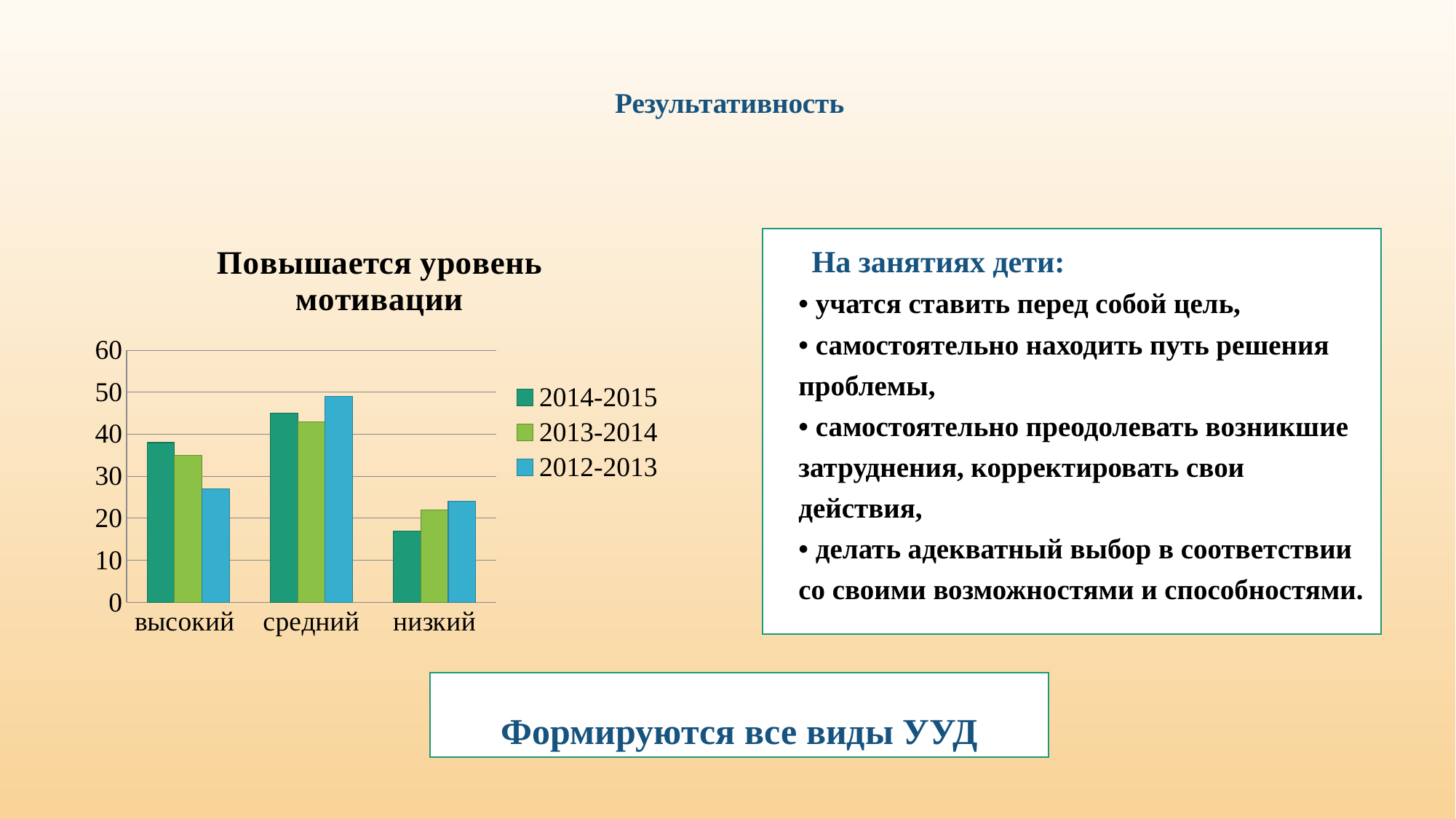
How many categories are shown on the x axis of the chart? 3 Which category has the highest value in the 2014-2015 series? средний Is the value for средний in the 2012-2013 series greater or less than 40? greater For the category высокий, which is larger: the 2014-2015 value or the 2012-2013 value? 2014-2015 What kind of chart is shown on the slide? bar chart Is the value for высокий in the 2012-2013 series greater or less than 30? less Is the value for высокий in the 2014-2015 series greater or less than 30? greater Which series has the lowest value for the category низкий? 2014-2015 Which series has the highest value for the category средний? 2012-2013 How many series does the chart legend list? 3 What is the title of the chart? Повышается уровень мотивации